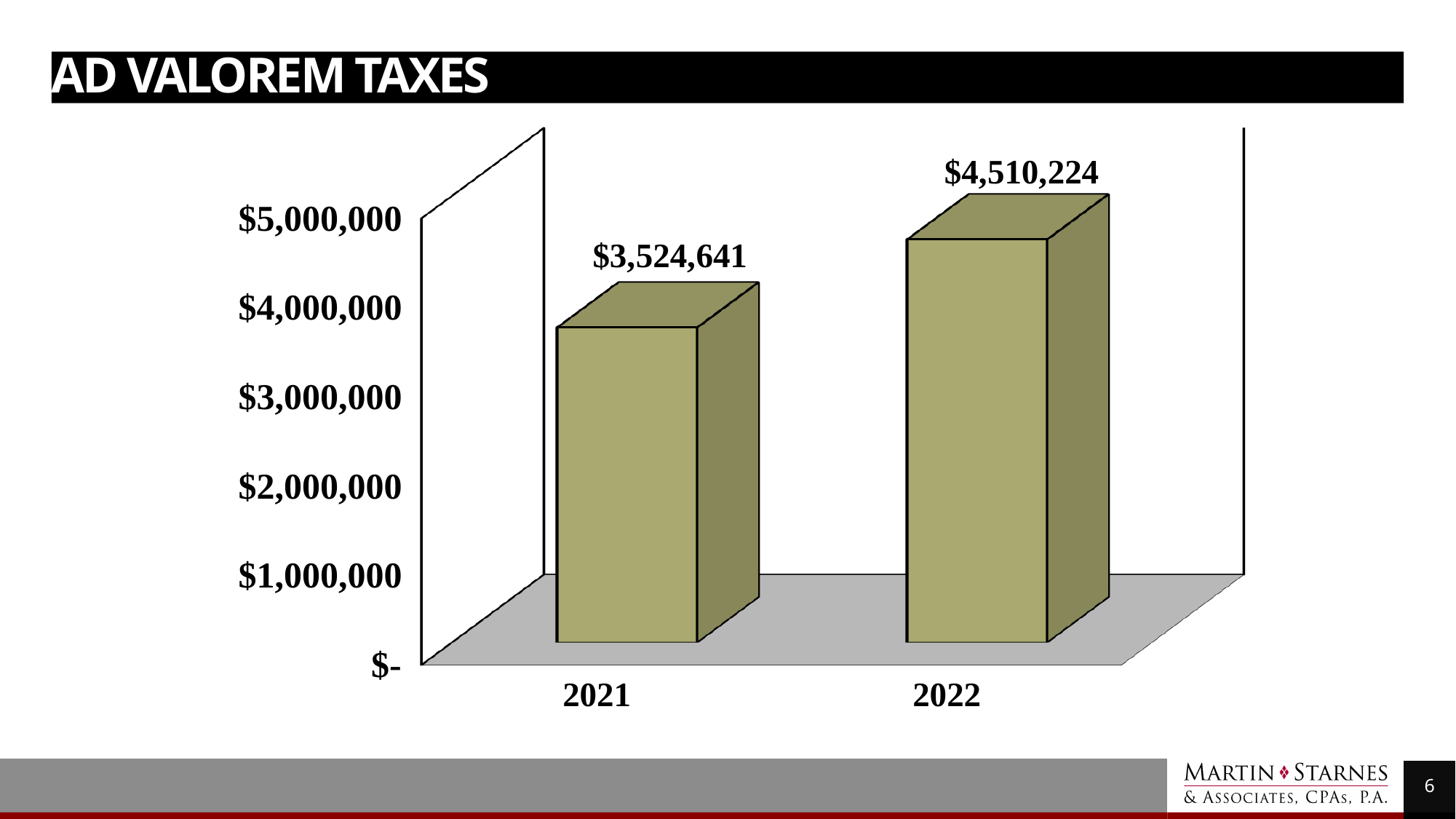
How many years are shown on the chart? 2 Is the value for 2021 greater or less than $4,000,000? less What is the title of the slide? AD VALOREM TAXES Which year has the lowest value? 2021 Do the values rise or fall from 2021 to 2022? rise Is the value for 2022 greater or less than $4,000,000? greater What is the value for 2021? $3,524,641 What kind of chart is shown on the slide? bar chart Which year has the highest value? 2022 What is the difference between the 2022 and 2021 values? $985,583 Which is larger, the value for 2021 or the value for 2022? 2022 What is the value for 2022? $4,510,224